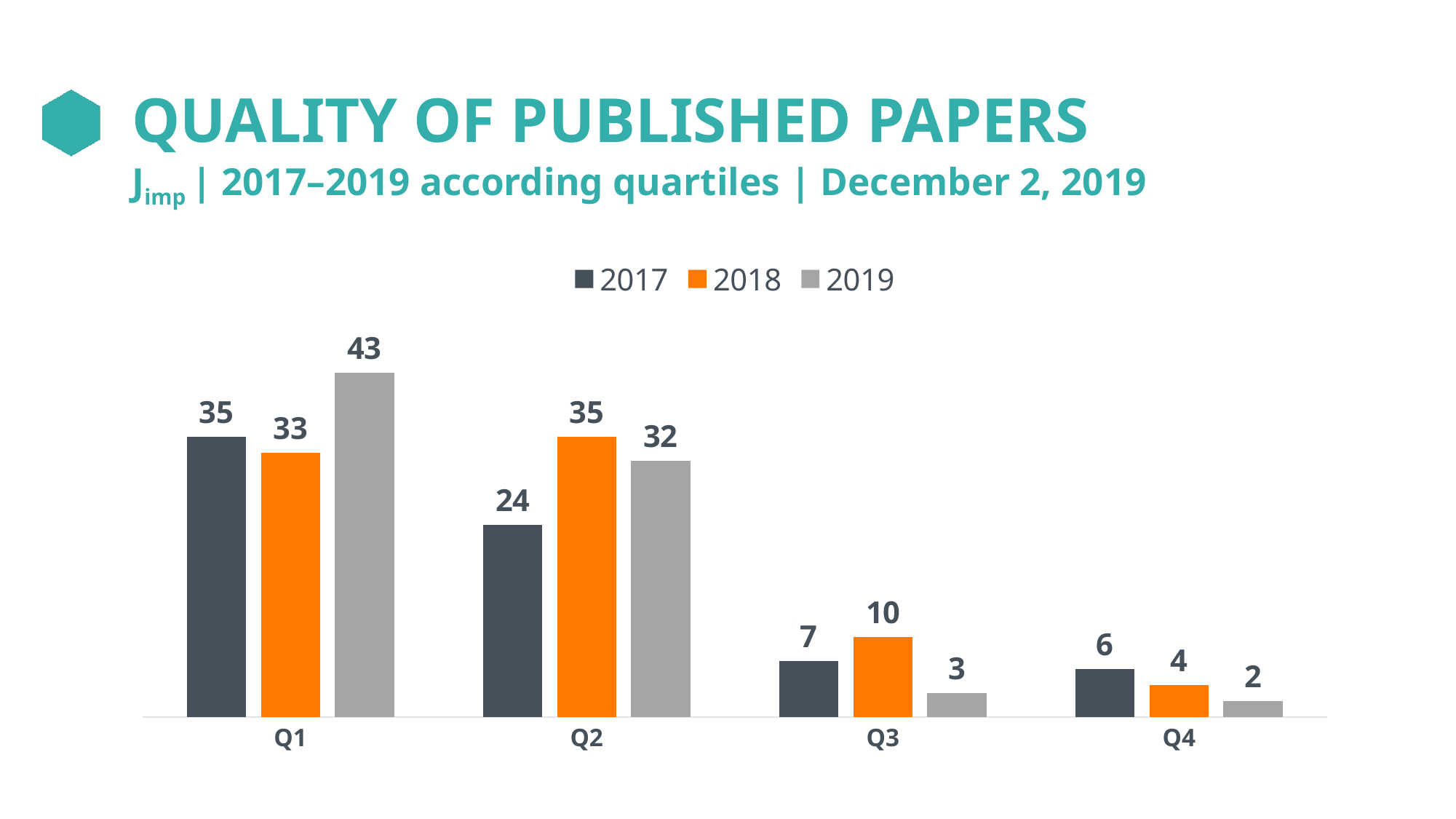
What is the value for 2017 in Q2? 24 What is the difference between the 2019 and 2017 values in Q1? 8 What is the value for 2019 in Q1? 43 How many quartile categories are shown on the x axis? 4 Which is larger in Q2: the 2018 value or the 2019 value? 2018 What is the value for 2019 in Q4? 2 How many series does the legend list? 3 What kind of chart is shown on the slide? Bar chart Do the 2019 values rise or fall from Q1 to Q4? Fall Which quartile has the lowest value for the 2017 series? Q4 Which quartile has the highest value for the 2018 series? Q2 What is the value for 2018 in Q3? 10